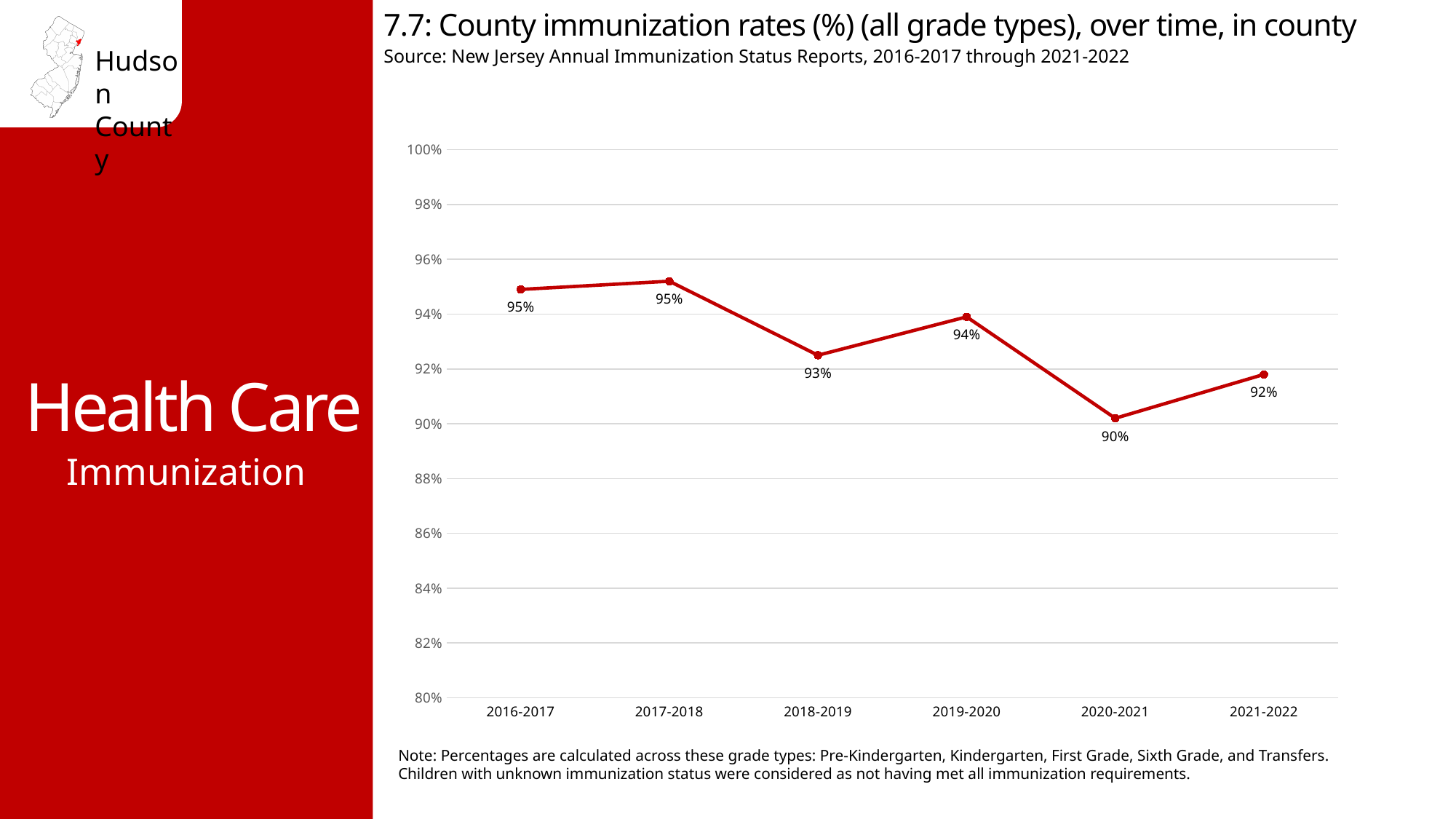
Is the value for 2020-2021 greater or less than 92%? less What is the immunization rate for 2016-2017? 95% Which is higher, the immunization rate in 2018-2019 or in 2019-2020? 2019-2020 What is the immunization rate for 2020-2021? 90% What kind of chart is shown on the slide? line chart What is the immunization rate for 2021-2022? 92% What is the difference between the immunization rate in 2017-2018 and in 2020-2021? 5 percentage points Which school year has the lowest immunization rate? 2020-2021 What is the immunization rate for 2018-2019? 93% Does the immunization rate rise or fall from 2019-2020 to 2020-2021? fall How many school years are plotted on the chart? 6 What is the immunization rate for 2019-2020? 94%